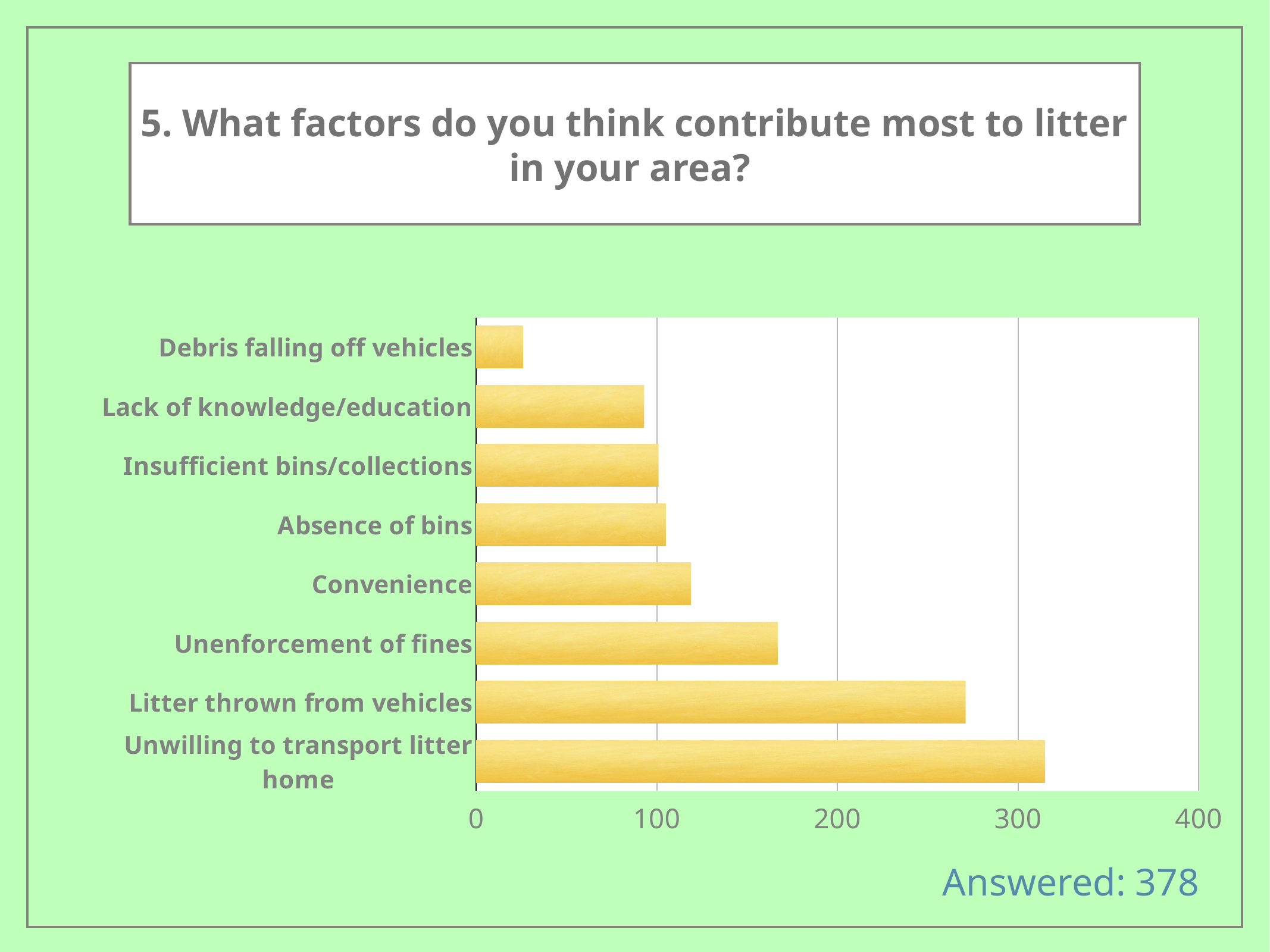
Is the value for Litter thrown from vehicles greater or less than 200? greater How many categories (factors) are plotted in the chart? 8 Which factor has the lowest value in the chart? Debris falling off vehicles Which factor has the highest value in the chart? Unwilling to transport litter home Is the value for Lack of knowledge/education greater or less than 100? less What kind of chart is shown on the slide? bar chart Which is larger: the value for Litter thrown from vehicles or the value for Unenforcement of fines? Litter thrown from vehicles Is the value for Unenforcement of fines greater or less than 200? less What is the title of the chart on the slide? 5. What factors do you think contribute most to litter in your area? How many respondents answered the question, according to the slide? 378